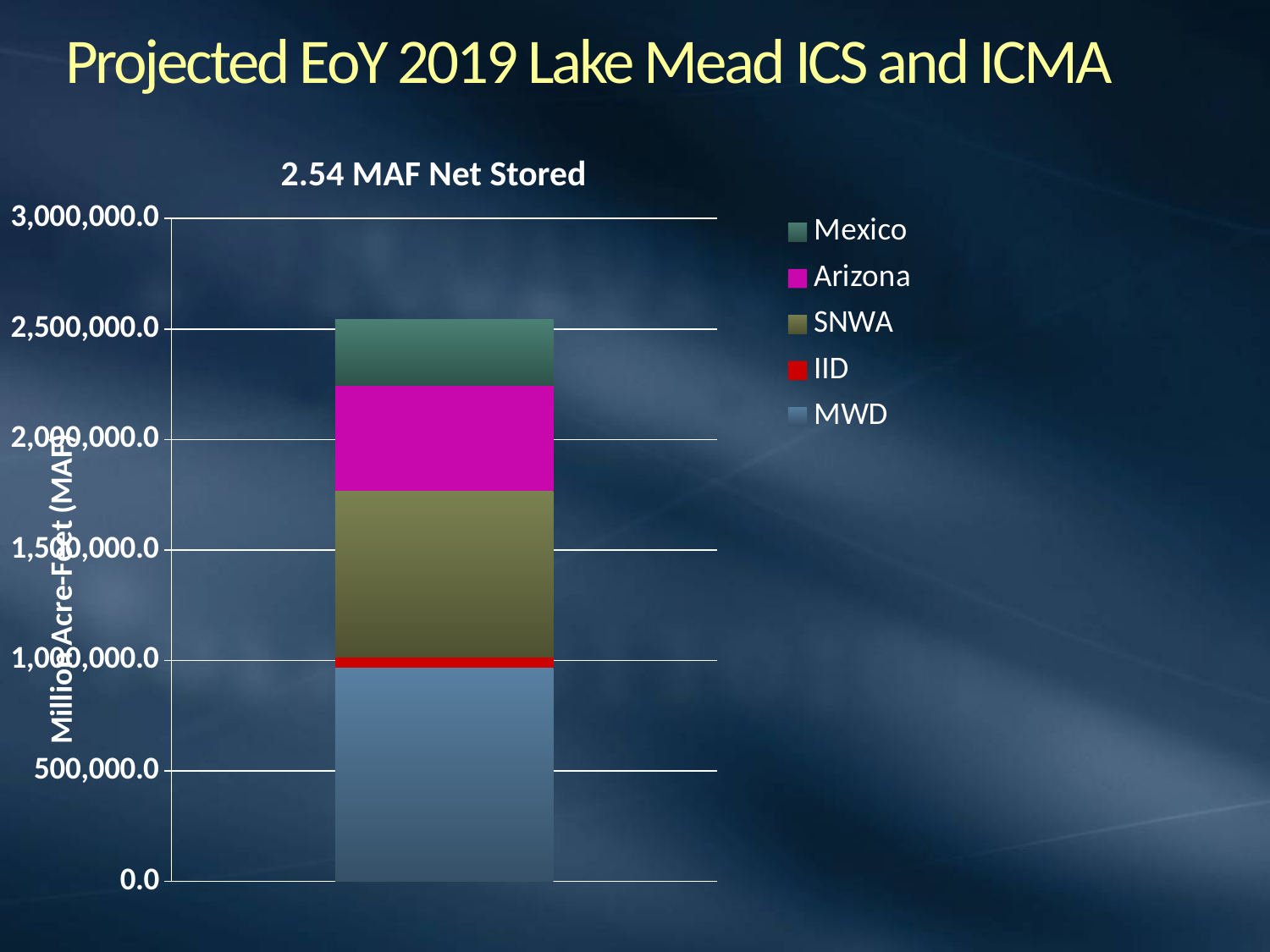
Is the value for MWD greater or less than 1,000,000.0? less What is the title of the chart? 2.54 MAF Net Stored According to the chart title, what is the total net stored amount? 2.54 MAF What kind of chart is shown on the slide? stacked bar chart How many series does the legend list? 5 How many bars are plotted in the chart? 1 Which segment is larger, MWD or Mexico? MWD Which series has the smallest segment in the stacked bar? IID Which segment is larger, SNWA or IID? SNWA Is the total height of the stacked bar greater or less than 3,000,000.0? less Which series has the largest segment in the stacked bar? MWD What is the label on the vertical axis? Million Acre-Feet (MAF)